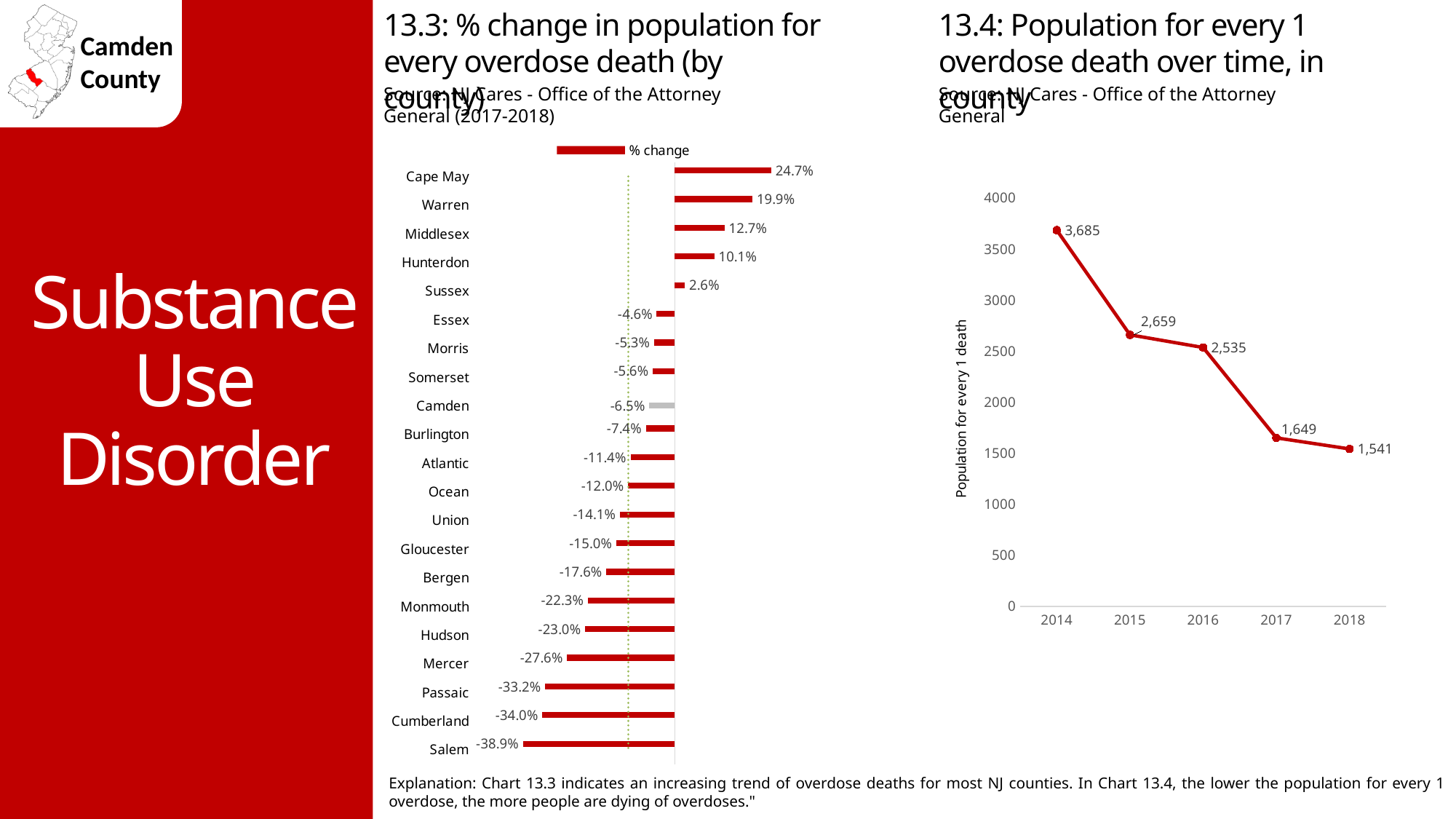
In chart 13.4, what is the value for 2018? 1,541 In chart 13.4, what is the label of the vertical axis? Population for every 1 death In chart 13.3 (% change in population for every overdose death), what is the value for Camden? -6.5% In chart 13.4, do the values rise or fall from 2014 to 2018? Fall In chart 13.3, which county has the highest % change? Cape May In chart 13.4, what is the difference between the 2014 and 2018 values? 2,144 In chart 13.3, which has a larger % change, Warren or Middlesex? Warren What kind of chart is chart 13.3? Bar chart In chart 13.3, how many counties are shown? 21 In chart 13.4 (Population for every 1 overdose death over time), what is the value for 2014? 3,685 In chart 13.3, which county has the lowest % change? Salem In chart 13.3, what is the value for Gloucester? -15.0%